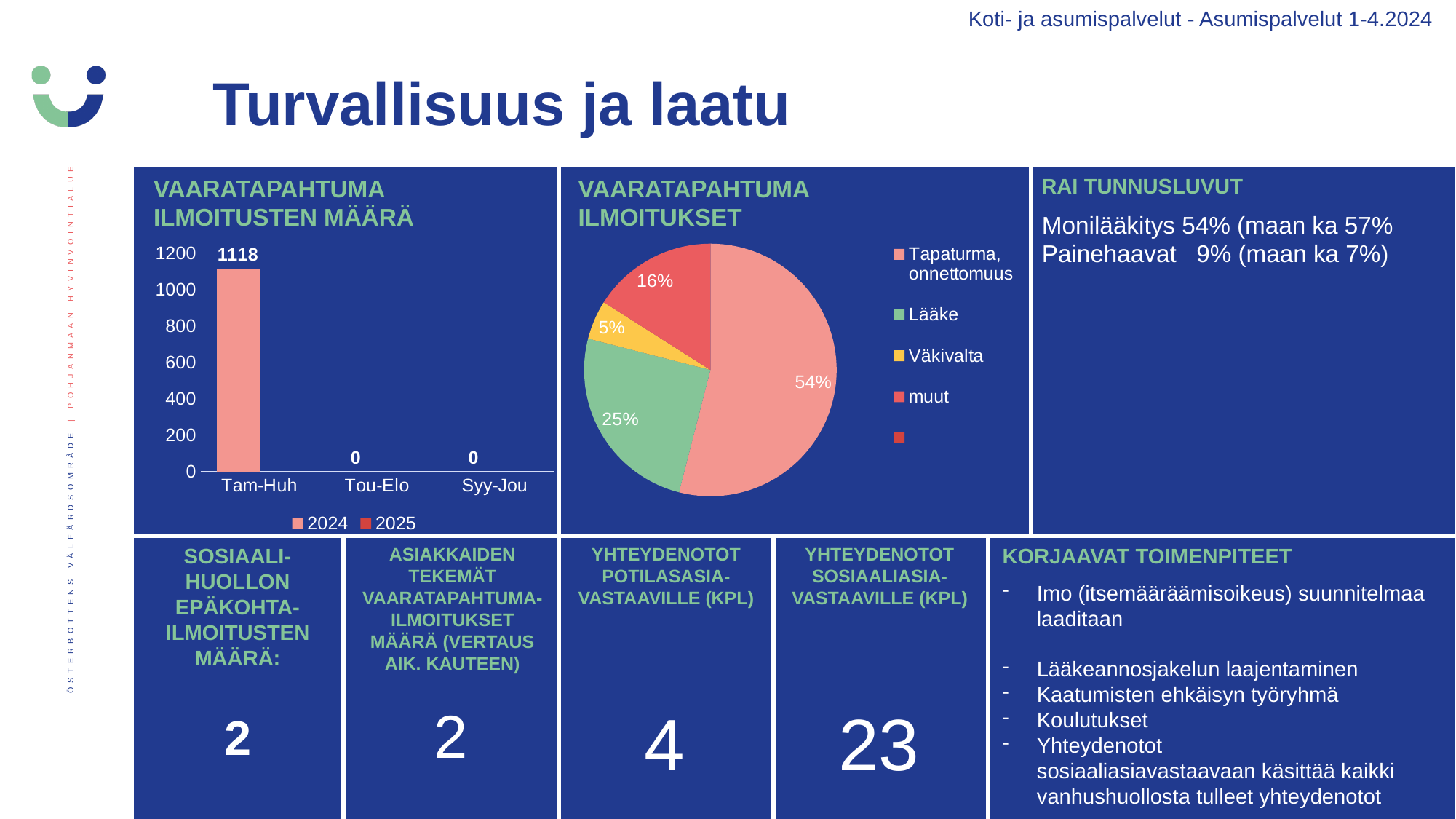
In the chart titled VAARATAPAHTUMA ILMOITUKSET, what share does Lääke have? 25% In the chart titled VAARATAPAHTUMA ILMOITUKSET, which slice is the smallest? Väkivalta What kind of chart is the one titled VAARATAPAHTUMA ILMOITUSTEN MÄÄRÄ? bar chart In the chart titled VAARATAPAHTUMA ILMOITUKSET, which is larger, Lääke or muut? Lääke In the chart titled VAARATAPAHTUMA ILMOITUKSET, what share does Tapaturma, onnettomuus have? 54% In the chart titled VAARATAPAHTUMA ILMOITUSTEN MÄÄRÄ, how many series does the legend list? 2 In the chart titled VAARATAPAHTUMA ILMOITUSTEN MÄÄRÄ, which category has the highest value? Tam-Huh In the chart titled VAARATAPAHTUMA ILMOITUSTEN MÄÄRÄ, is the value for Tam-Huh greater or less than 1000? greater In the chart titled VAARATAPAHTUMA ILMOITUSTEN MÄÄRÄ, how many categories are shown on the x axis? 3 What kind of chart is the one titled VAARATAPAHTUMA ILMOITUKSET? pie chart In the chart titled VAARATAPAHTUMA ILMOITUSTEN MÄÄRÄ, what is the value for Tam-Huh? 1118 In the chart titled VAARATAPAHTUMA ILMOITUSTEN MÄÄRÄ, what is the value for Tou-Elo? 0